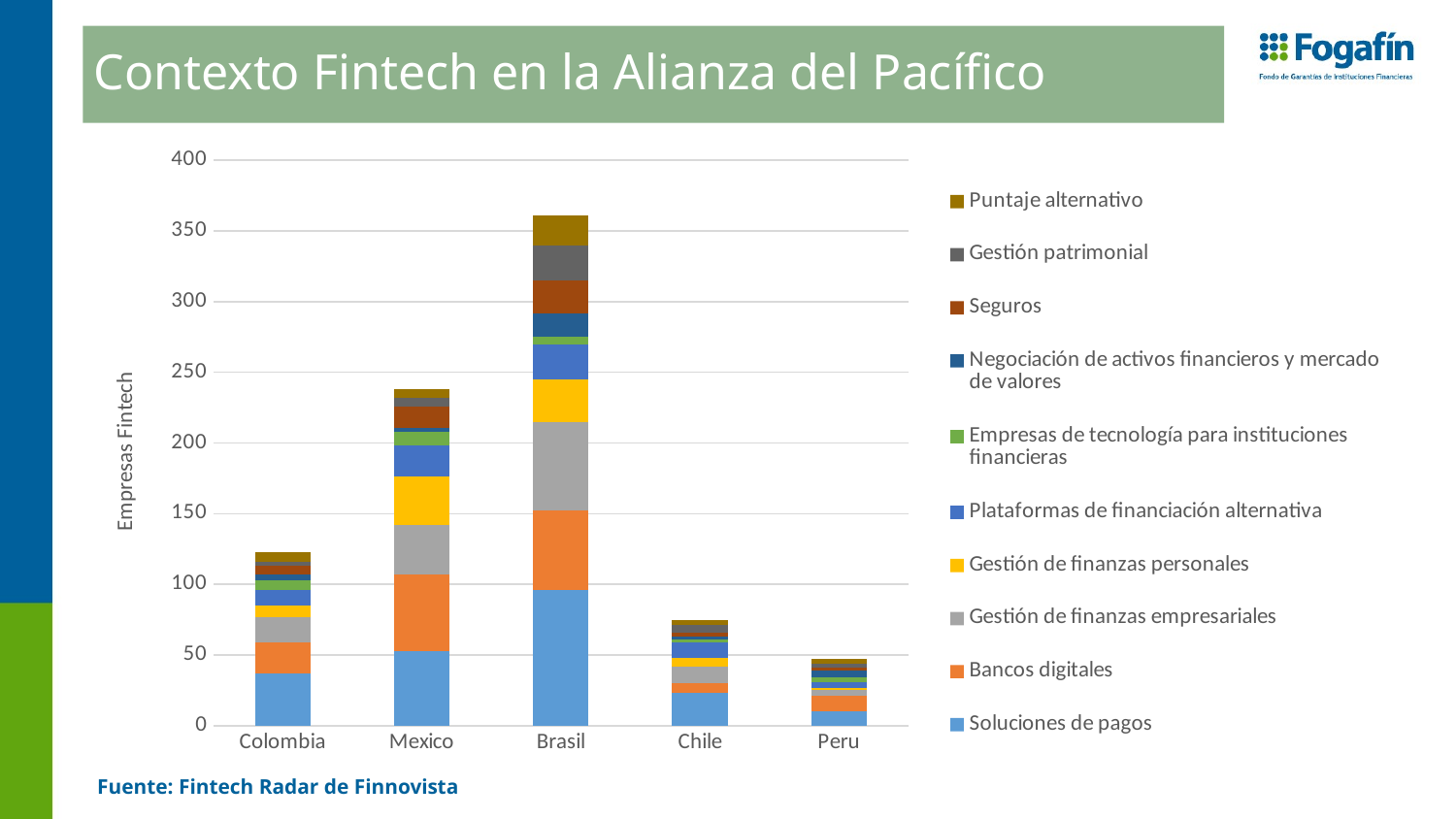
Which country has the shortest stacked bar? Peru How many countries are shown on the x axis of the chart? 5 Which country has a taller stacked bar, Mexico or Chile? Mexico Which country has a taller stacked bar, Colombia or Peru? Colombia Is the total height of the Mexico bar greater or less than 200? greater What is the label on the vertical axis of the chart? Empresas Fintech How many series does the chart's legend list? 10 Is the total height of the Chile bar greater or less than 100? less What kind of chart is shown on the slide? bar chart Which country has the tallest stacked bar? Brasil Which series is shown at the bottom of each stacked bar, in light blue? Soluciones de pagos Is the total height of the Brasil bar greater or less than 300? greater